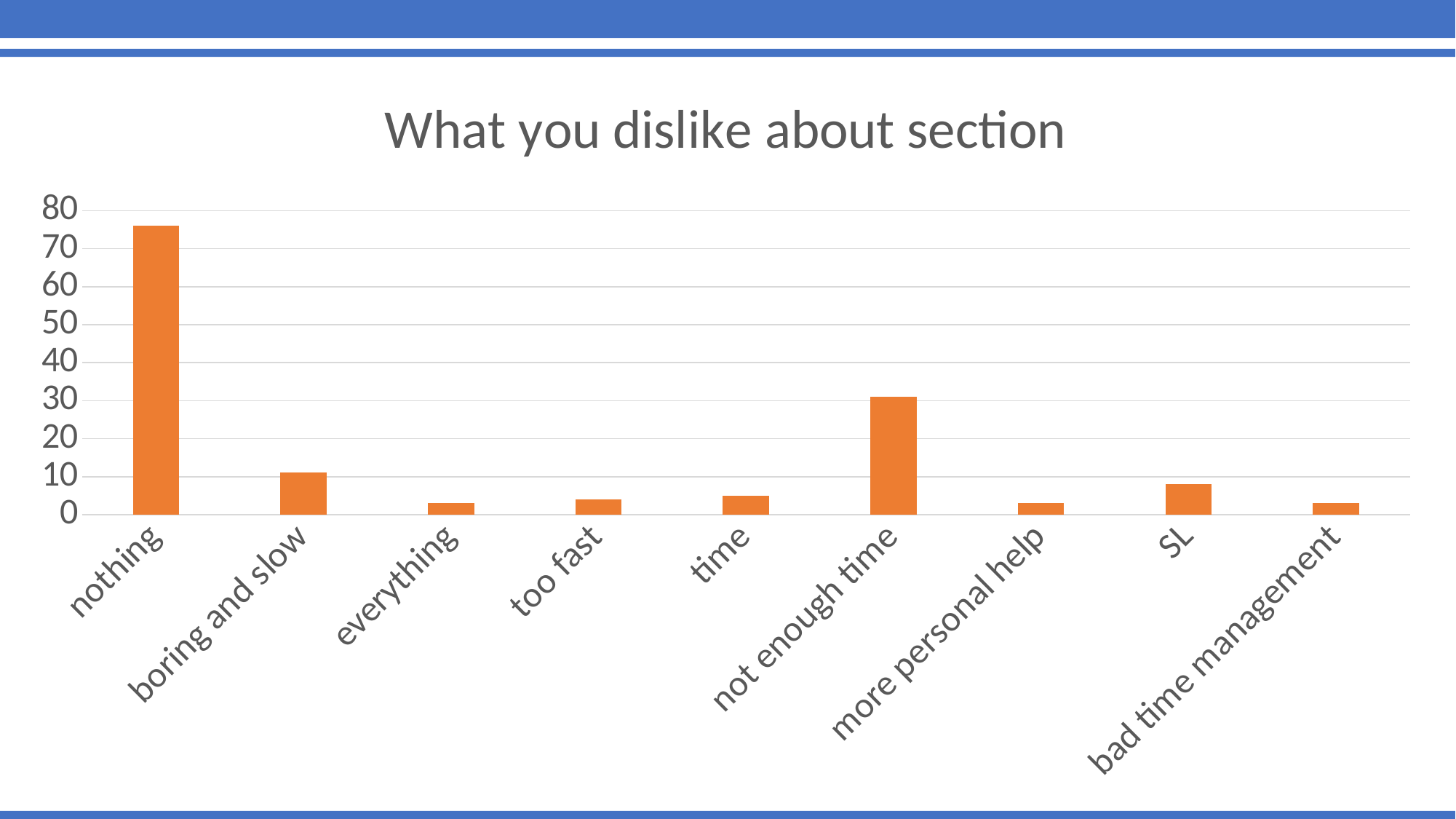
Which is larger, the value for 'not enough time' or the value for 'boring and slow'? not enough time Is the value for 'SL' greater or less than 10? less Which category has the highest value? nothing Is the value for 'everything' greater or less than 10? less Which is larger, the value for 'nothing' or the value for 'not enough time'? nothing How many categories are shown on the x axis of the chart? 9 Is the value for 'nothing' greater or less than 70? greater What colour are the bars in the chart? orange What type of chart is shown on the slide? bar chart What is the title of the chart? What you dislike about section